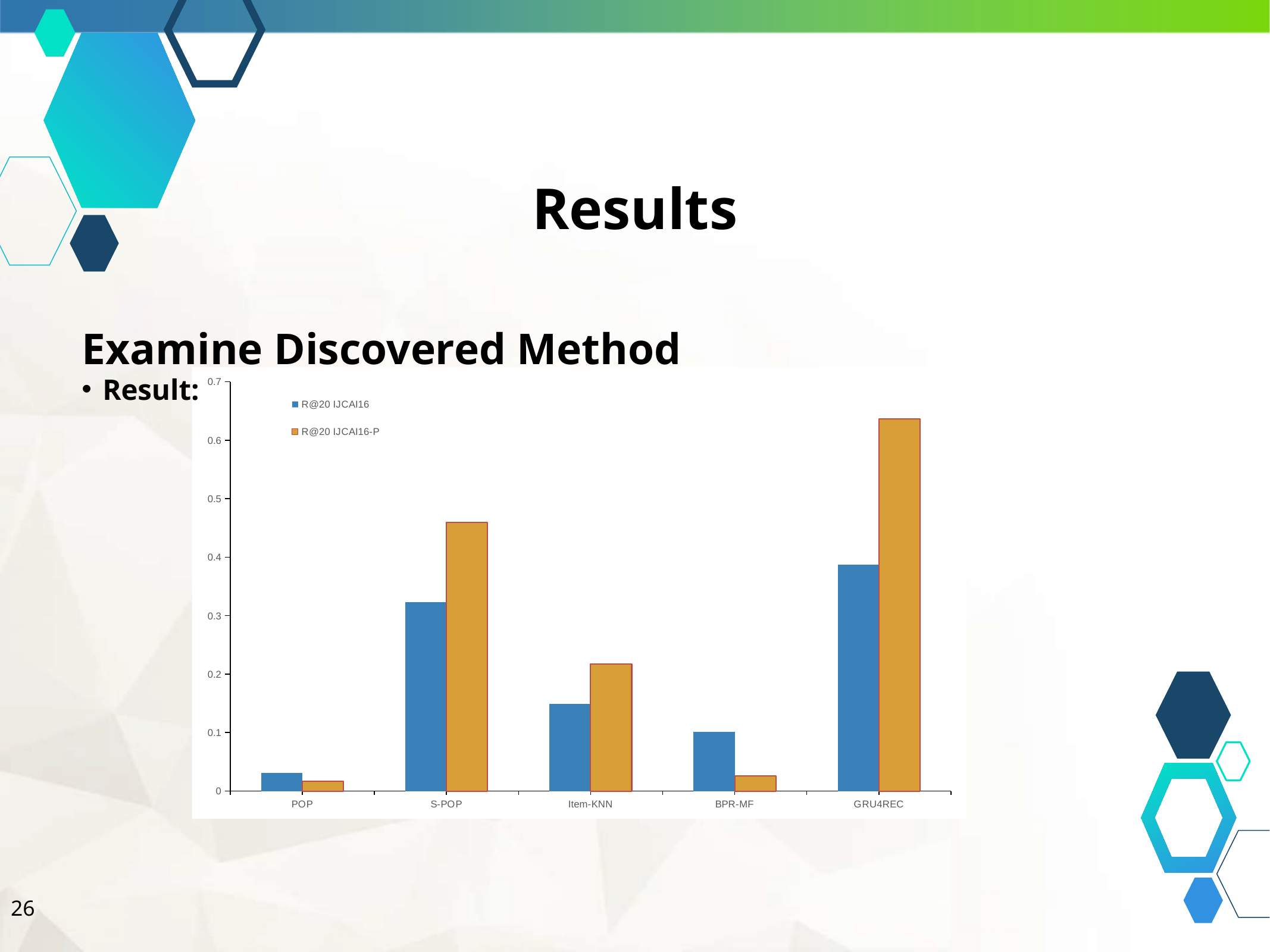
Is the R@20 IJCAI16-P value for S-POP greater or less than 0.4? greater Which category has the lowest value for R@20 IJCAI16-P? POP How many categories are shown on the x axis of the chart? 5 How many series does the chart's legend list? 2 Which category has the highest value for R@20 IJCAI16? GRU4REC Which series is shown in orange in the chart? R@20 IJCAI16-P What kind of chart is shown on the slide? bar chart For BPR-MF, which series has the larger value, R@20 IJCAI16 or R@20 IJCAI16-P? R@20 IJCAI16 Is the R@20 IJCAI16 value for Item-KNN greater or less than 0.2? less Is the R@20 IJCAI16-P value for GRU4REC greater or less than 0.6? greater Which category has the highest value for R@20 IJCAI16-P? GRU4REC Which category has the lowest value for R@20 IJCAI16? POP